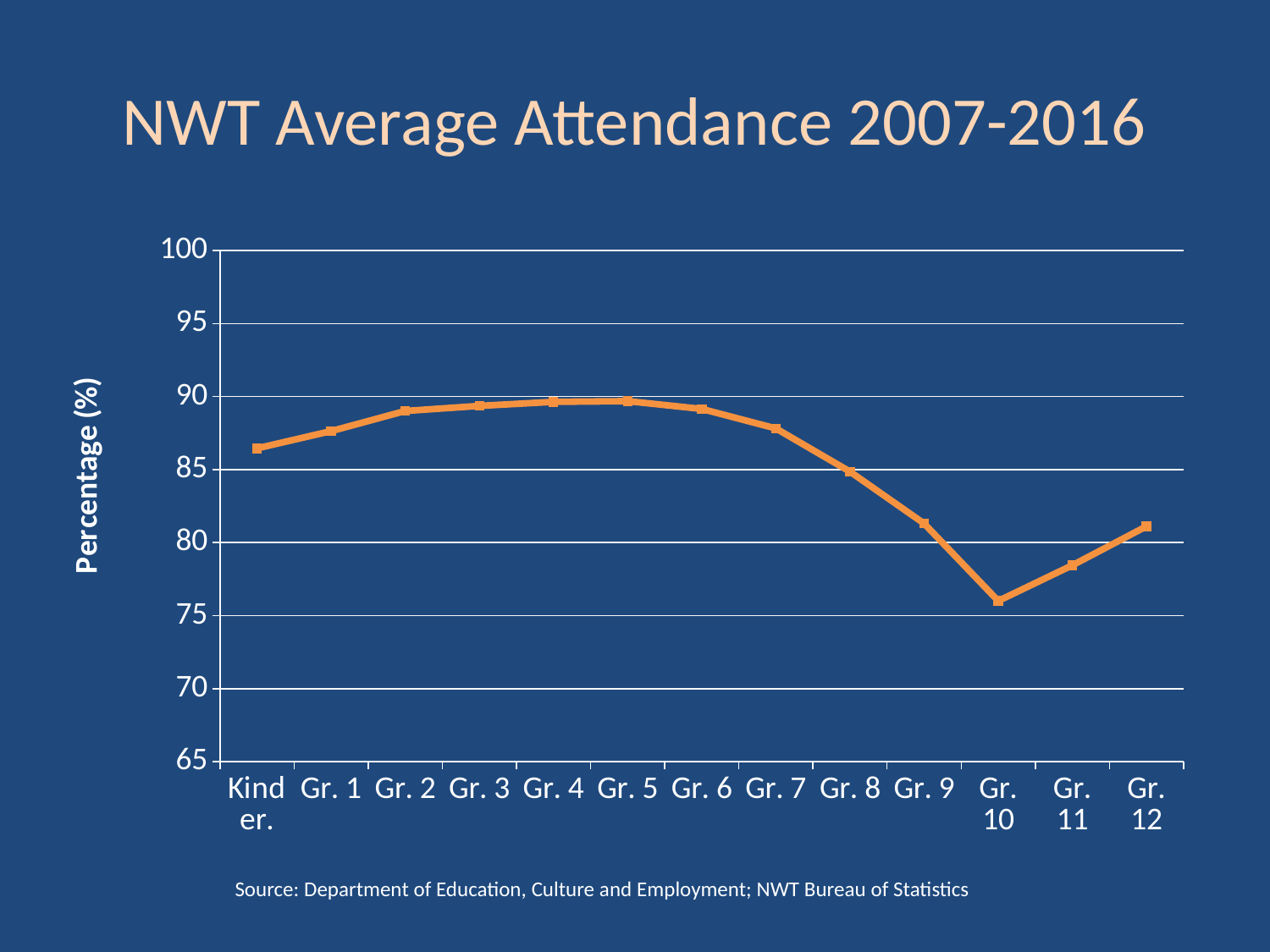
How many grade categories are plotted along the x axis? 13 Is the value for Gr. 1 greater or less than 85? greater Is the value for Kinder. greater or less than 85? greater What is the title of the chart? NWT Average Attendance 2007-2016 Is the value for Gr. 7 greater or less than 90? less Which is larger, the value for Gr. 7 or the value for Gr. 8? Gr. 7 Do the values rise or fall from Gr. 5 to Gr. 10? fall What is the label of the vertical axis? Percentage (%) What kind of chart is shown on the slide? Line chart Which grade has the lowest average attendance? Gr. 10 Which is larger, the value for Kinder. or the value for Gr. 10? Kinder.